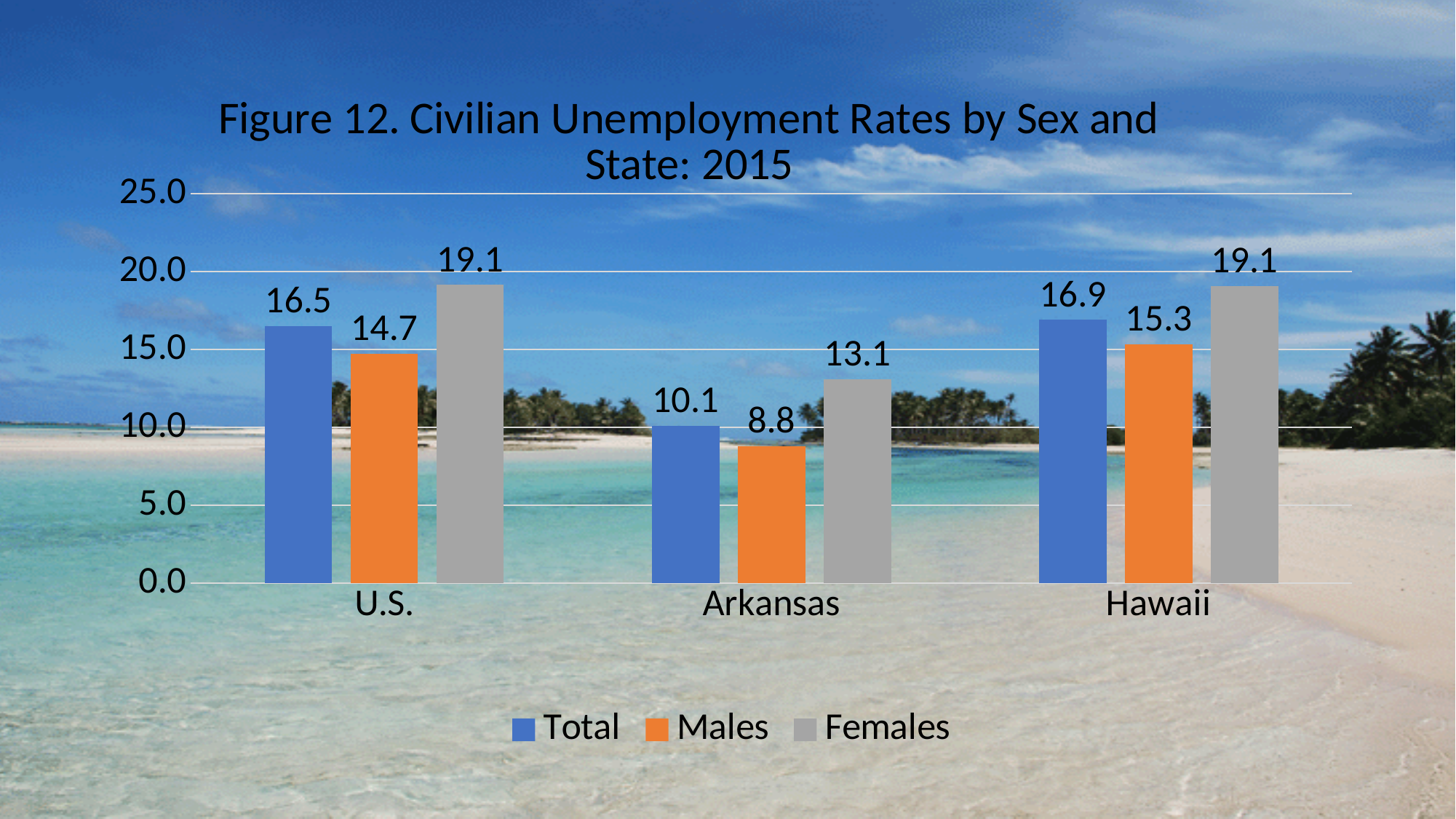
What is the Total unemployment rate for Hawaii? 16.9 How many states or regions are shown on the x axis? 3 Which state or region has the highest Males unemployment rate? Hawaii What kind of chart is shown on the slide? Bar chart Which is larger, the Females rate for Arkansas or the Males rate for the U.S.? Males rate for the U.S. How many series does the legend list? 3 What is the difference between the Females and Males unemployment rates in Arkansas? 4.3 What is the difference between the Total unemployment rates of Hawaii and the U.S.? 0.4 What is the title of the chart? Figure 12. Civilian Unemployment Rates by Sex and State: 2015 What is the Males unemployment rate for Arkansas? 8.8 What is the Females unemployment rate for the U.S.? 19.1 Which state or region has the lowest Total unemployment rate? Arkansas